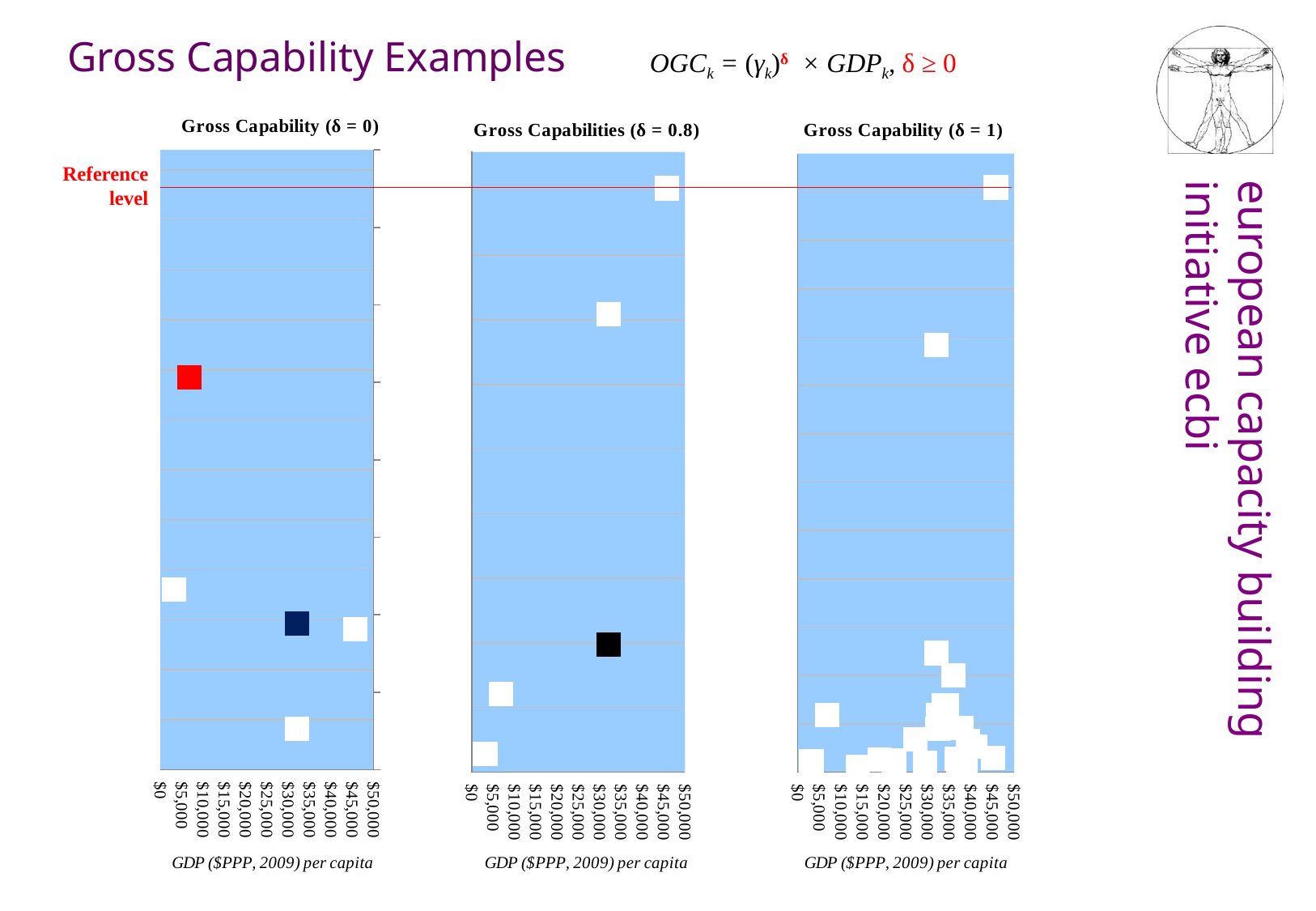
In the Gross Capabilities (δ = 0.8) chart, is the GDP per capita of the black square greater or less than $25,000? greater How many charts are shown on the slide? 3 In the Gross Capability (δ = 1) chart, what is the lowest value shown on the x axis? $0 In the Gross Capability (δ = 0) chart, what is the interval between consecutive x-axis ticks? $5,000 What kind of chart is the leftmost chart, Gross Capability (δ = 0)? scatter chart In the Gross Capability (δ = 1) chart, is the GDP per capita of the white square nearest the reference level greater or less than $40,000? greater What is the title of the middle chart? Gross Capabilities (δ = 0.8) In the Gross Capability (δ = 0) chart, is the GDP per capita of the red square greater or less than $10,000? less In the Gross Capability (δ = 0) chart, which is plotted higher on the vertical axis, the red square or the dark blue square? the red square What label is written in red next to the horizontal line crossing all three charts? Reference level In the Gross Capability (δ = 0) chart, what is the highest value shown on the x axis? $50,000